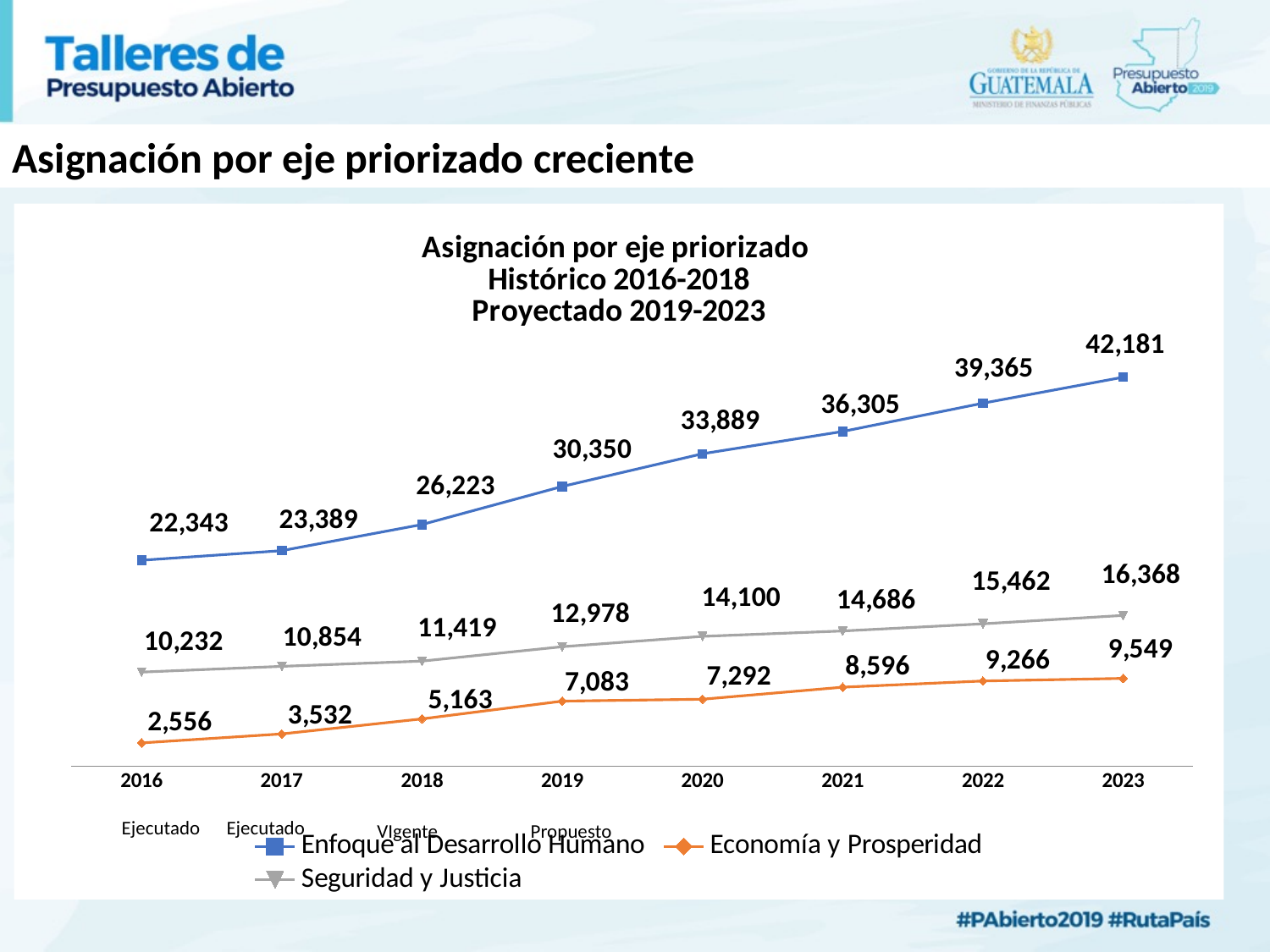
What is the title of the chart? Asignación por eje priorizado Histórico 2016-2018 Proyectado 2019-2023 How many series does the legend list? 3 How many years are shown on the x axis? 8 What is the value for Economía y Prosperidad in 2016? 2,556 What is the value for Enfoque al Desarrollo Humano in 2023? 42,181 In which year is the value for Economía y Prosperidad lowest? 2016 What is the difference between the Enfoque al Desarrollo Humano values for 2023 and 2016? 19,838 Does the value for Enfoque al Desarrollo Humano rise or fall from 2016 to 2023? Rise Which series has the larger value in 2020, Seguridad y Justicia or Economía y Prosperidad? Seguridad y Justicia What type of chart is shown on the slide? Line chart In which year is the value for Seguridad y Justicia highest? 2023 What is the value for Seguridad y Justicia in 2019? 12,978